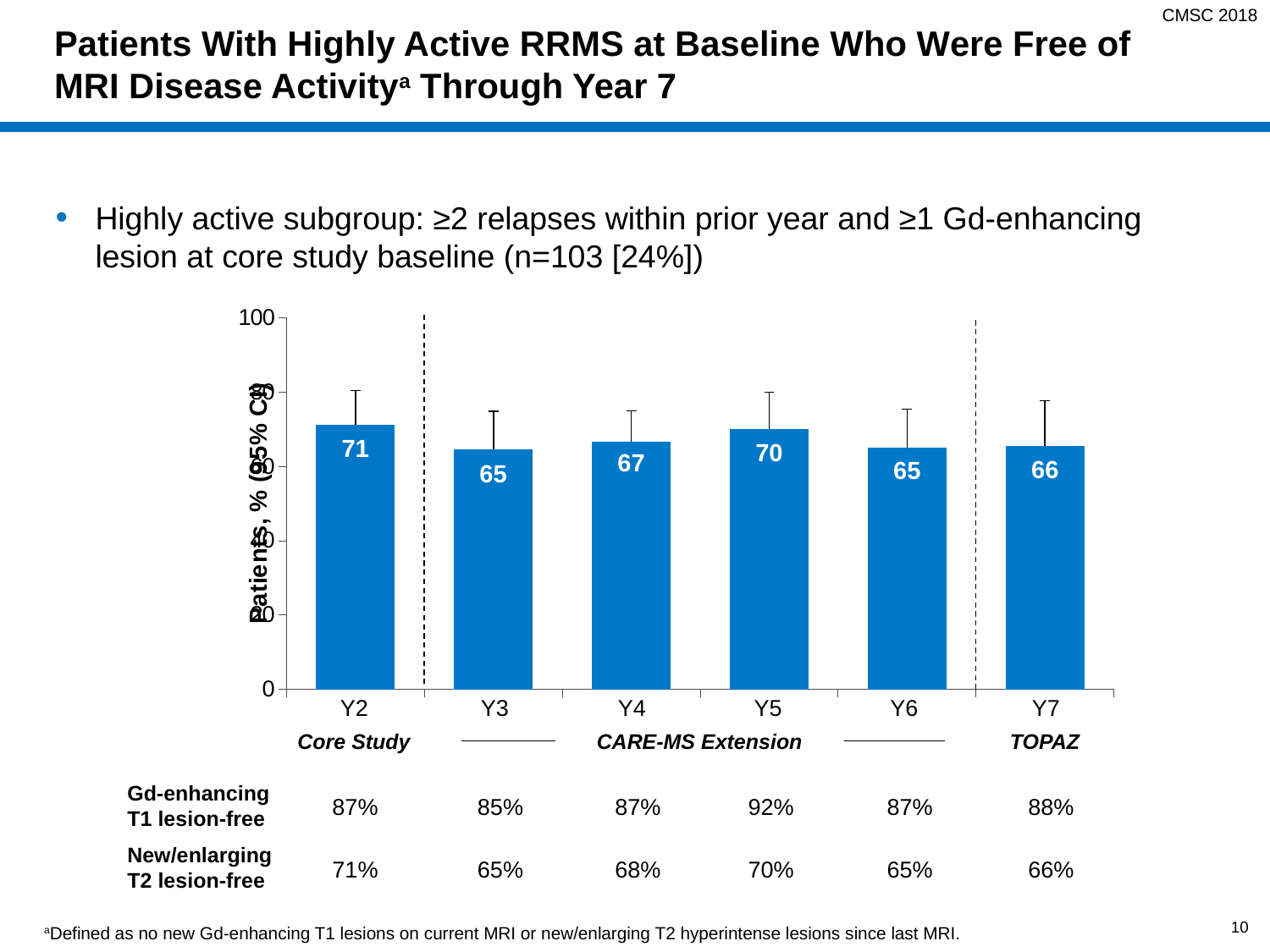
What kind of chart is shown on the slide? bar chart How many bars are plotted in the chart? 6 Which study phase label appears under the Y7 bar? TOPAZ What is the value shown on the bar for Y2? 71 Which year has the highest bar? Y2 Is the value for Y2 greater or less than 60? greater What is the difference between the values for Y2 and Y3? 6 What is the value shown on the bar for Y5? 70 Does the value rise or fall from Y2 to Y3? fall What is the value shown on the bar for Y7? 66 Which is larger, the value for Y5 or the value for Y4? Y5 What is the value shown on the bar for Y4? 67